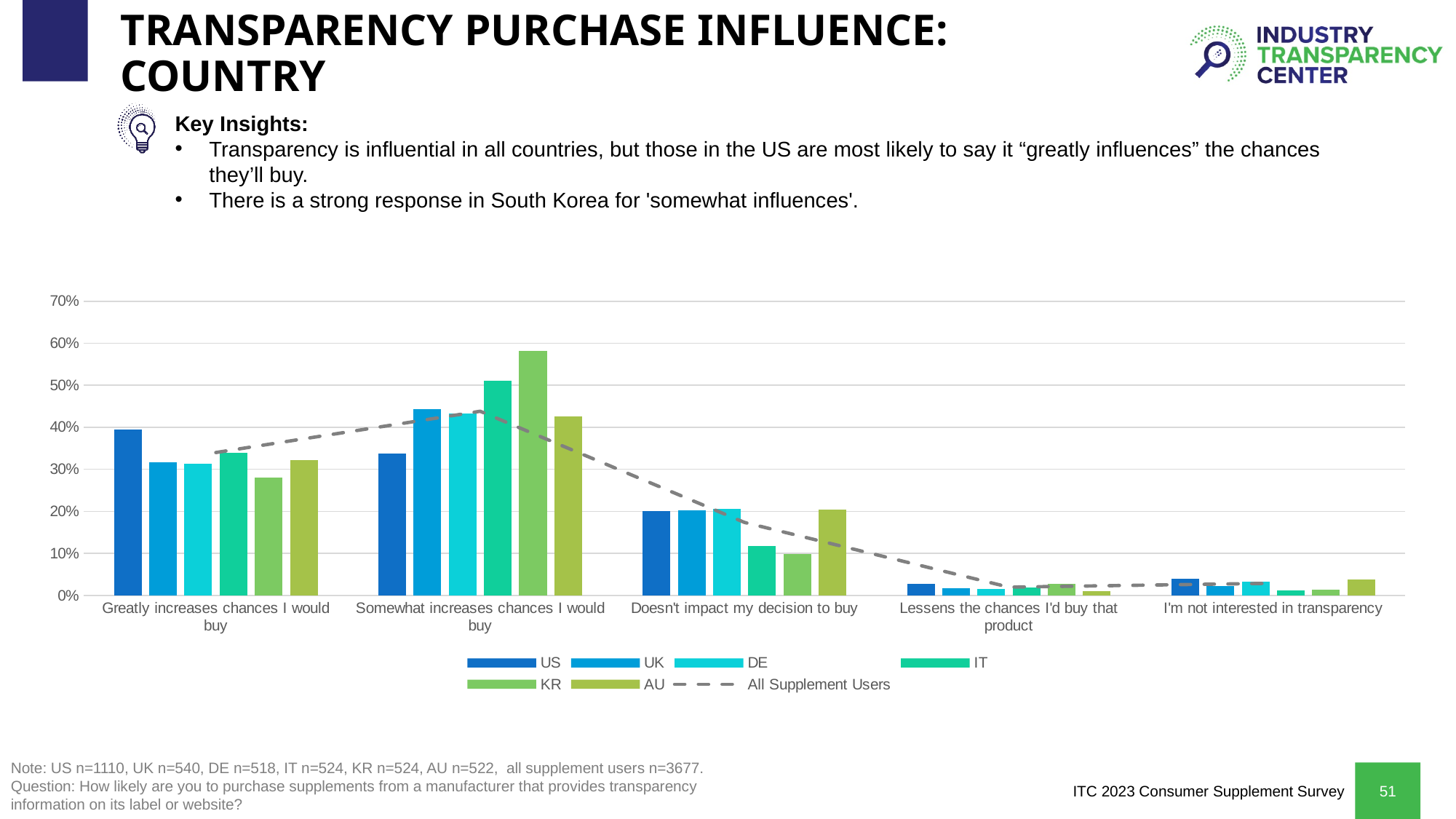
How many series does the legend list? 7 How many response categories are shown along the x axis? 5 What kind of chart is shown on the slide? combination bar and line chart Is the value for KR in "Somewhat increases chances I would buy" greater or less than 50%? greater For "Greatly increases chances I would buy", which is larger, US or KR? US Which series is shown as a dashed line in the chart? All Supplement Users Is the value for US in "Greatly increases chances I would buy" greater or less than 30%? greater Which country has the lowest bar for "Greatly increases chances I would buy"? KR Which country has the highest bar for "Greatly increases chances I would buy"? US Which country has the highest bar for "Somewhat increases chances I would buy"? KR Is the value for AU in "Doesn't impact my decision to buy" greater or less than 10%? greater For "Somewhat increases chances I would buy", which is larger, KR or AU? KR